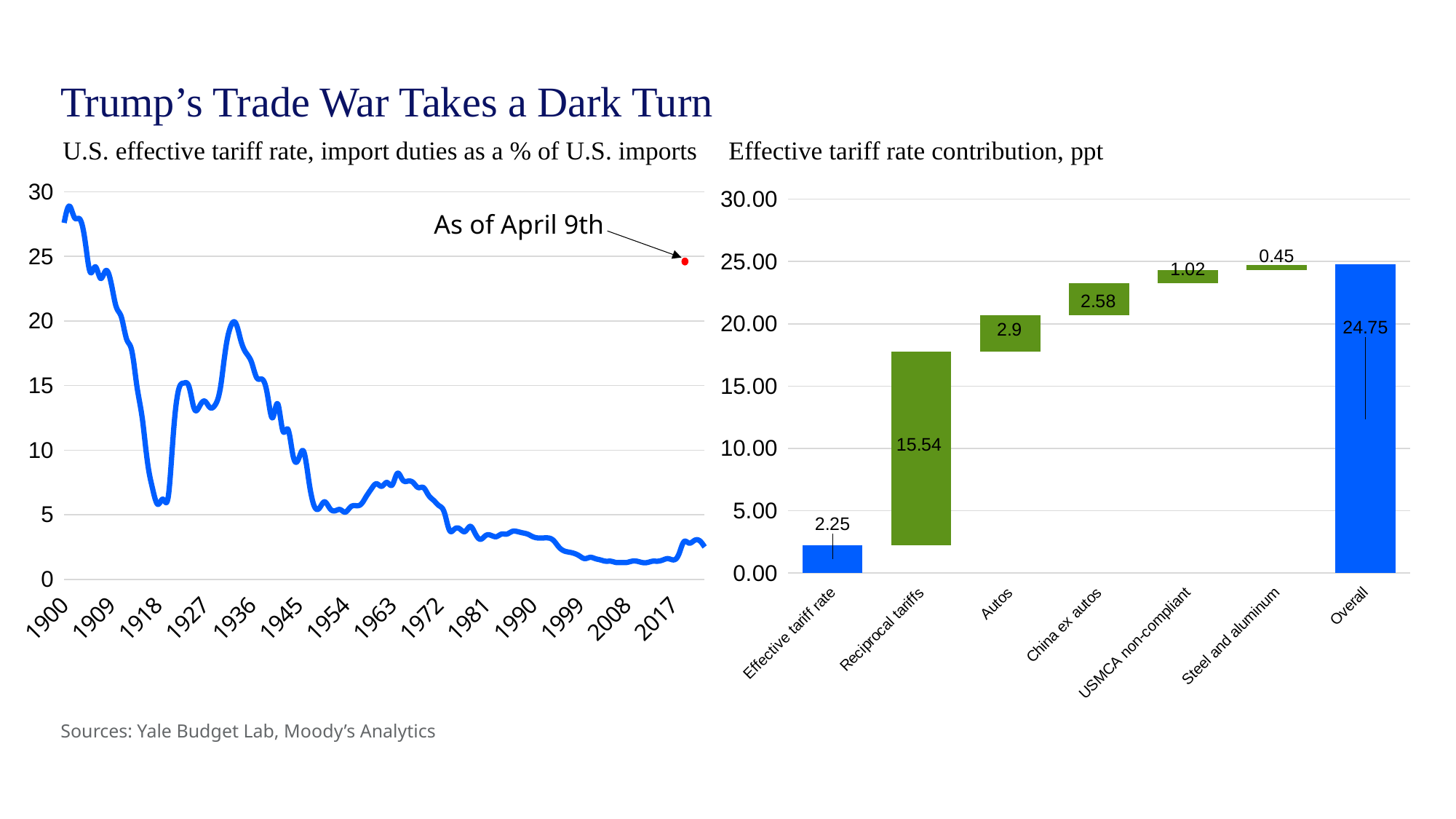
In the 'U.S. effective tariff rate' line chart, is the value in 1900 greater or less than 25? greater In the 'Effective tariff rate contribution, ppt' chart, which contribution category (excluding Overall) has the largest value? Reciprocal tariffs In the 'Effective tariff rate contribution, ppt' chart, what is the value for Overall? 24.75 How many categories are shown on the x axis of the 'Effective tariff rate contribution, ppt' chart? 7 In the 'Effective tariff rate contribution, ppt' chart, what is the value for Reciprocal tariffs? 15.54 In the 'Effective tariff rate contribution, ppt' chart, which category has the smallest value? Steel and aluminum In the 'Effective tariff rate contribution, ppt' chart, what is the value for Steel and aluminum? 0.45 In the 'Effective tariff rate contribution, ppt' chart, which is larger: Autos or China ex autos? Autos What kind of chart is the 'U.S. effective tariff rate, import duties as a % of U.S. imports' chart? Line chart In the 'Effective tariff rate contribution, ppt' chart, what is the value for China ex autos? 2.58 In the 'Effective tariff rate contribution, ppt' chart, what is the difference between the Autos value and the USMCA non-compliant value? 1.88 In the 'U.S. effective tariff rate' line chart, does the tariff rate generally rise or fall from 1900 to 2017? Fall